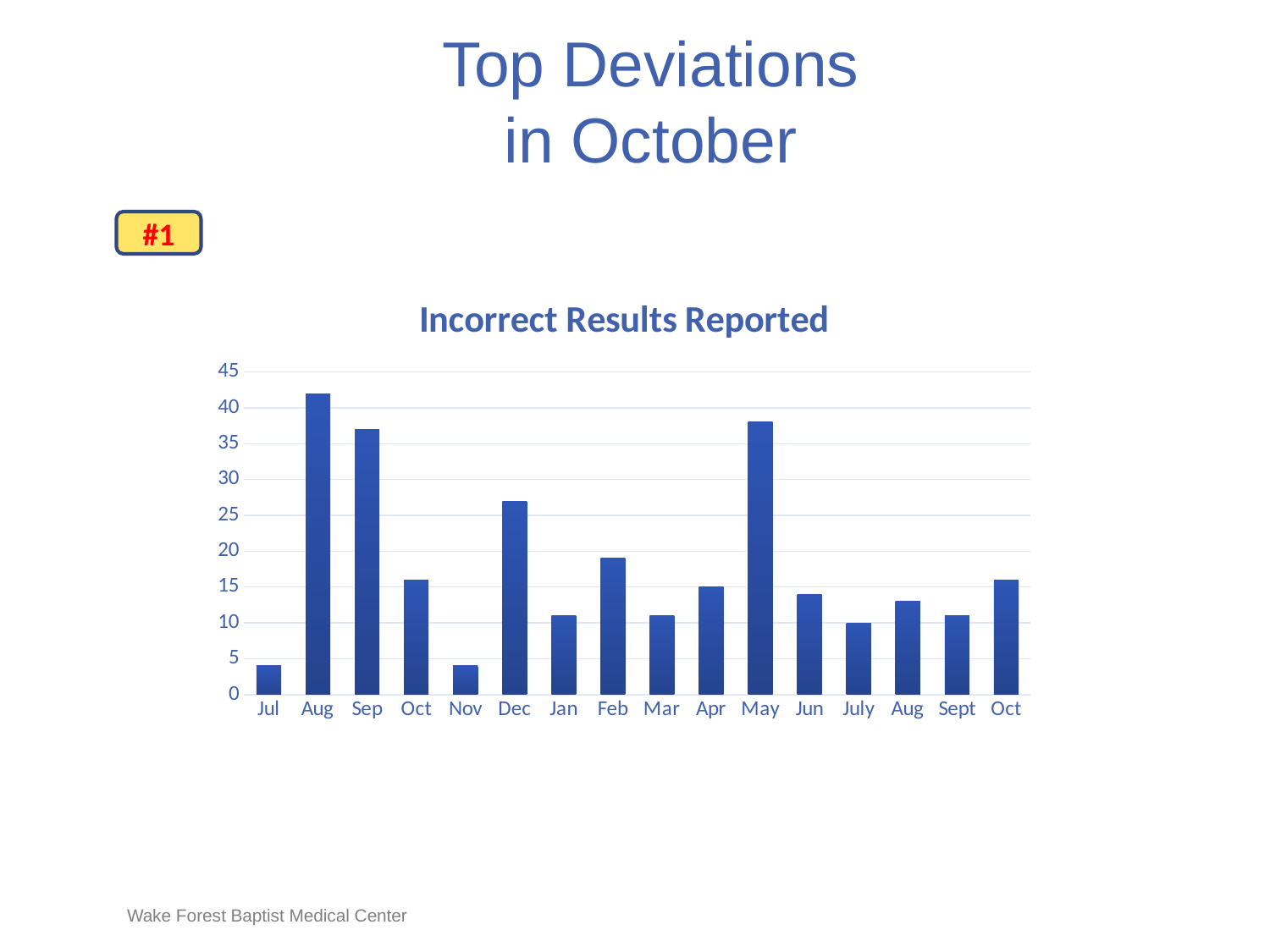
Is the value for Jun greater or less than 15? less Is the value for Dec greater or less than 25? greater Is the value for Jul (the first Jul) greater or less than 5? less What kind of chart is shown on the slide? bar chart What is the title of the chart? Incorrect Results Reported Which is larger, the value for the first Aug or the value for the second Aug? the first Aug How many bars (months) are plotted in the chart? 16 Do the values rise or fall from Aug to Nov (the first Aug through Nov)? fall Which month has the highest value in the chart? Aug (the first Aug) Which is larger, the value for Dec or the value for Feb? Dec